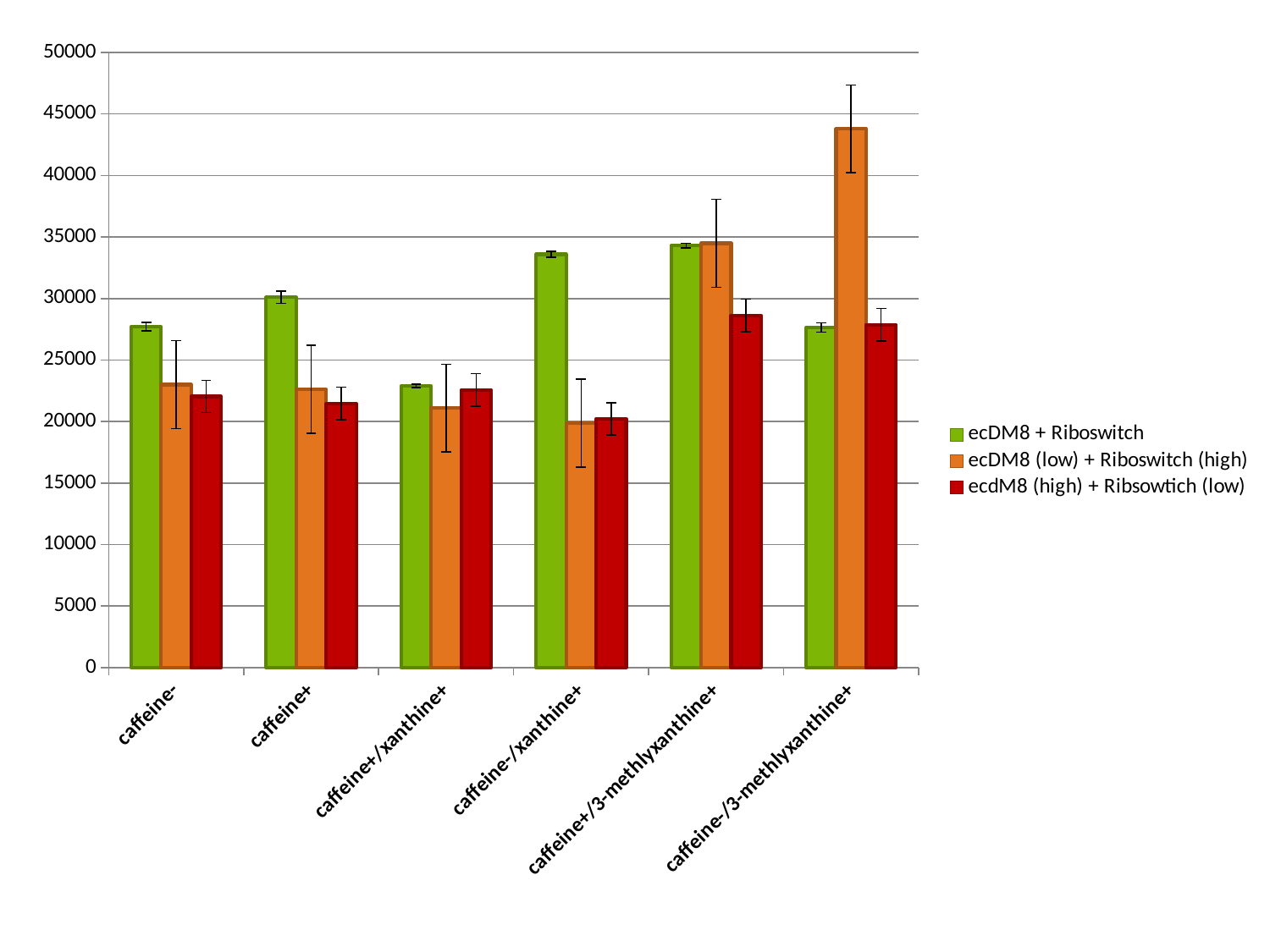
For which category is the ecDM8 (low) + Riboswitch (high) bar highest? caffeine-/3-methlyxanthine+ For which category is the ecDM8 (low) + Riboswitch (high) bar lowest? caffeine-/xanthine+ Is the ecDM8 + Riboswitch value for caffeine-/xanthine+ greater or less than 30000? greater What kind of chart is shown on the slide? bar chart How many categories are shown on the x axis? 6 For caffeine-, which is larger: ecDM8 + Riboswitch or ecDM8 (low) + Riboswitch (high)? ecDM8 + Riboswitch Which series has the tallest bar anywhere on the chart? ecDM8 (low) + Riboswitch (high) Is the ecDM8 (low) + Riboswitch (high) value for caffeine-/3-methlyxanthine+ greater or less than 40000? greater Is the ecdM8 (high) + Ribsowtich (low) value for caffeine- greater or less than 25000? less Which colour represents the ecDM8 + Riboswitch series in the legend? green How many series does the legend list? 3